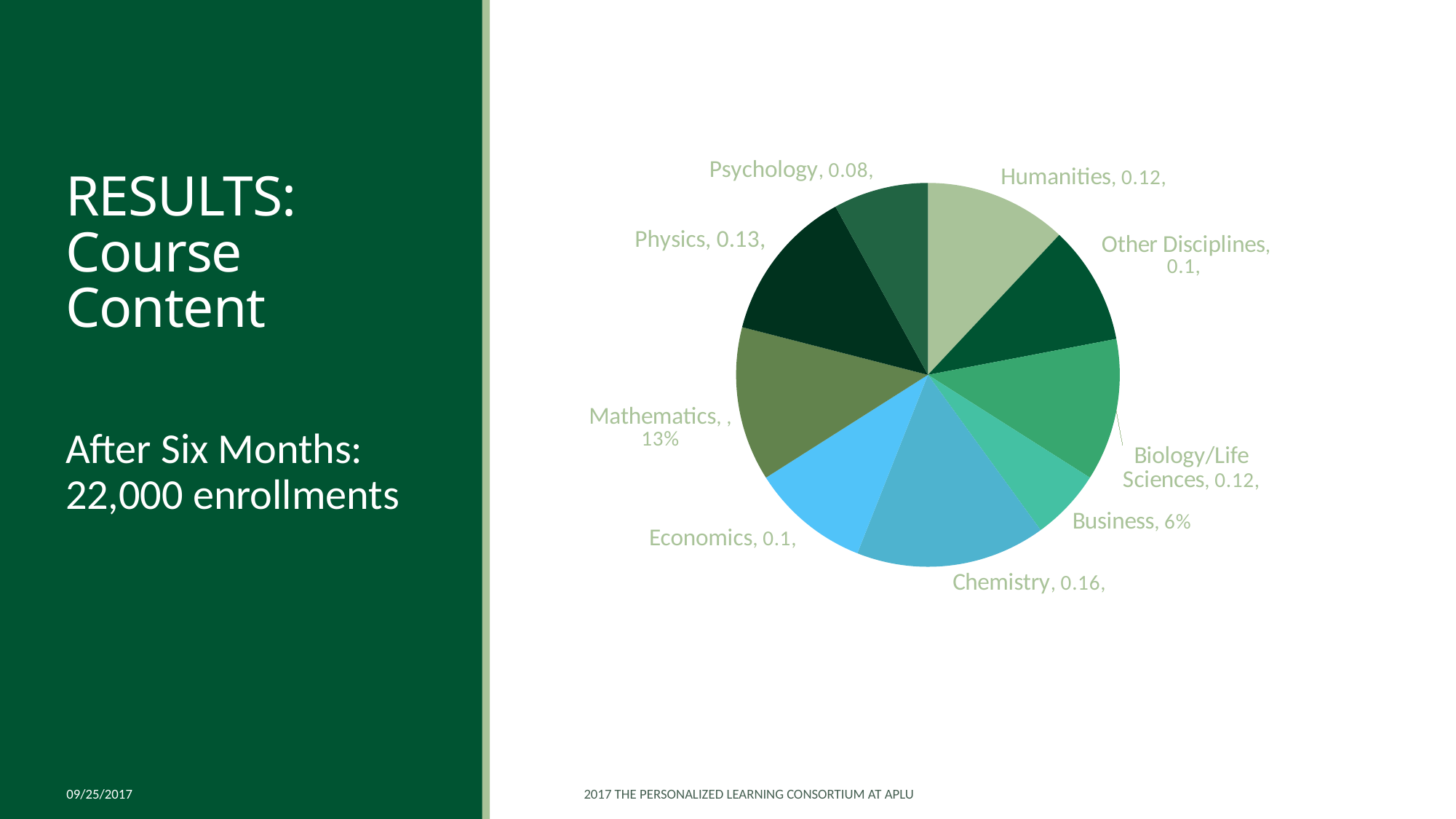
What is the value shown for Physics? 0.13 What is the value shown for Business? 6% Which is larger, the value for Physics or the value for Humanities? Physics What is the value shown for Psychology? 0.08 What is the value shown for Mathematics? 13% Which category has the smallest slice of the pie? Business What kind of chart is shown on the slide? pie chart Which category has the largest slice of the pie? Chemistry What is the value shown for Chemistry? 0.16 What is the difference between the values for Chemistry and Psychology? 0.08 How many categories are shown in the pie chart? 9 Which two categories both have a value of 0.1? Other Disciplines and Economics